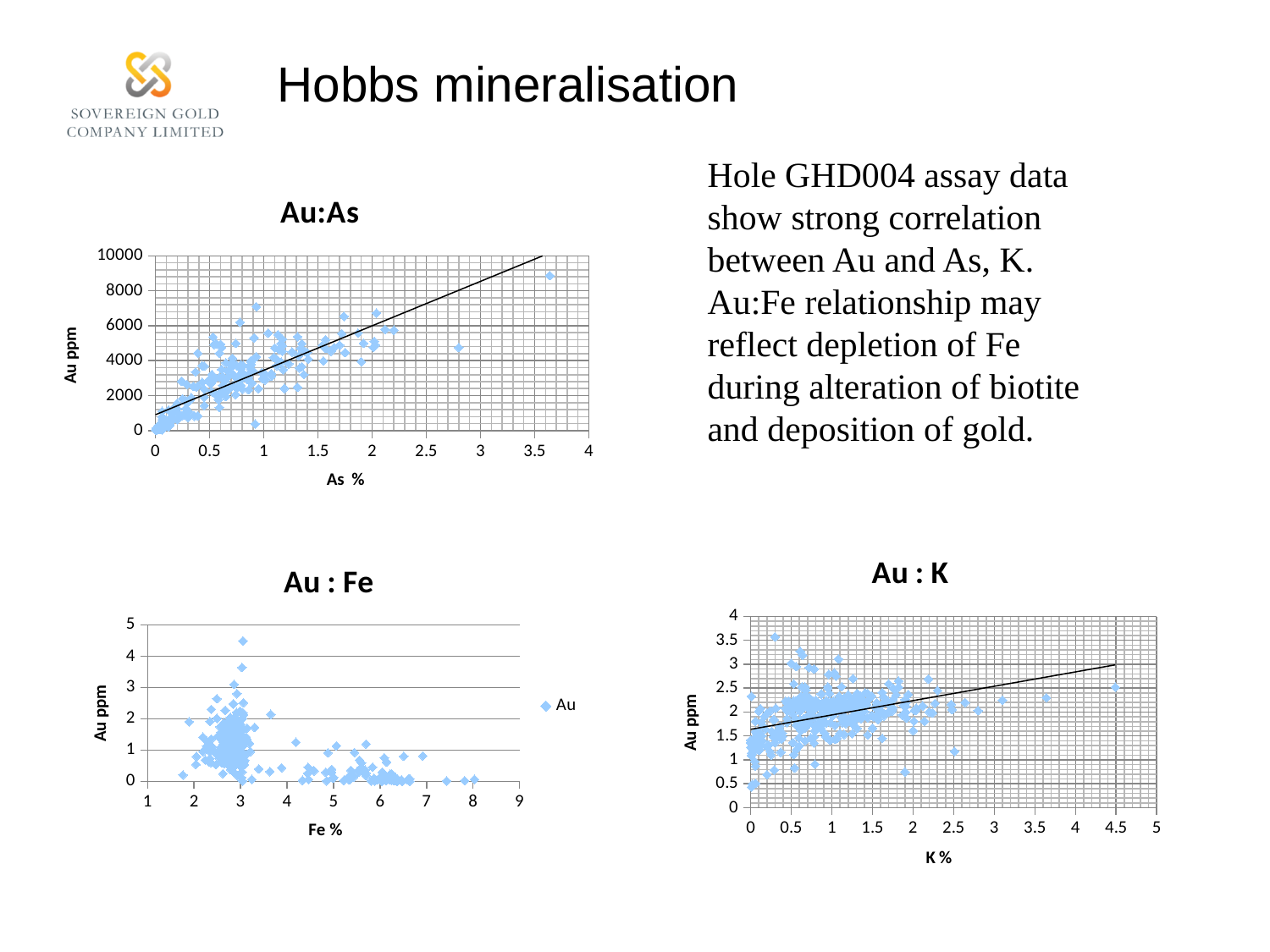
What kind of chart is the Au:As chart at the top left of the slide? scatter chart In the Au:As chart, do the Au ppm values rise or fall as As % increases along the x axis? rise In the Au : K chart, is the highest plotted Au ppm value greater or less than 3? greater What is the name of the series shown in the legend of the Au : Fe chart? Au In the Au:As chart, is the Au ppm value of the point plotted near As 3.6% greater or less than 8000? greater In the Au : Fe chart, do the Au ppm values generally rise or fall as Fe % increases along the x axis? fall What is the x-axis title of the Au:As chart? As % How many series does the legend of the Au : Fe chart list? 1 What kind of chart is the Au : K chart at the bottom right of the slide? scatter chart In the Au : K chart, do the Au ppm values rise or fall as K % increases along the x axis? rise In the Au : Fe chart, is the highest plotted Au ppm value greater or less than 4? greater